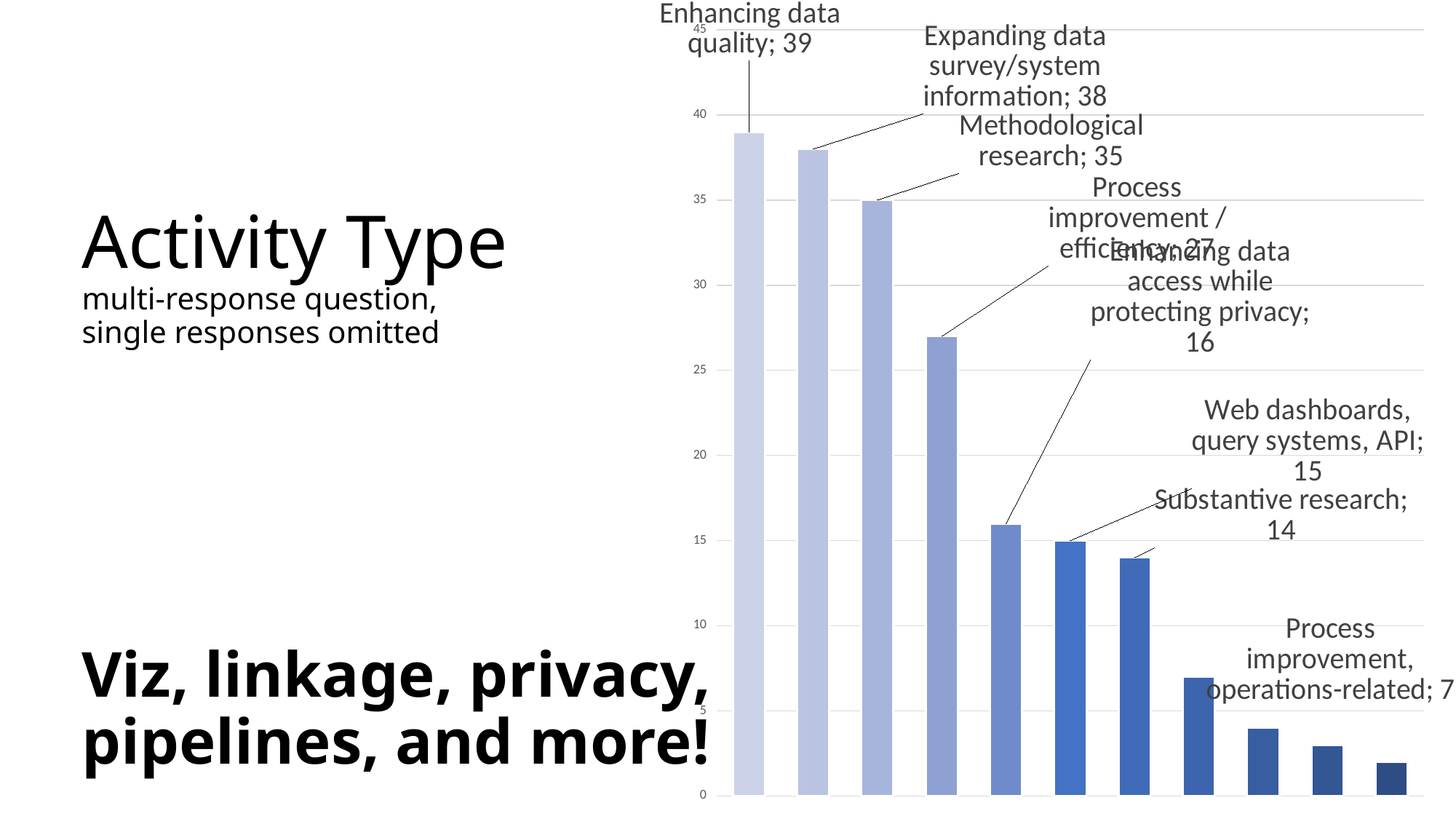
What is the value for Methodological research? 35 What kind of chart is shown on the slide? bar chart Do the values rise or fall from left to right across the bars? fall Is the value for the rightmost bar greater or less than 5? less Which is larger, Web dashboards, query systems, API or Enhancing data access while protecting privacy? Enhancing data access while protecting privacy What is the value for Enhancing data quality? 39 How many bars are plotted in the chart? 11 What is the value for Process improvement, operations-related? 7 What is the difference between Methodological research and Process improvement / efficiency? 8 What is the difference between Enhancing data quality and Expanding data survey/system information? 1 Which activity type has the highest value? Enhancing data quality What is the value for Substantive research? 14